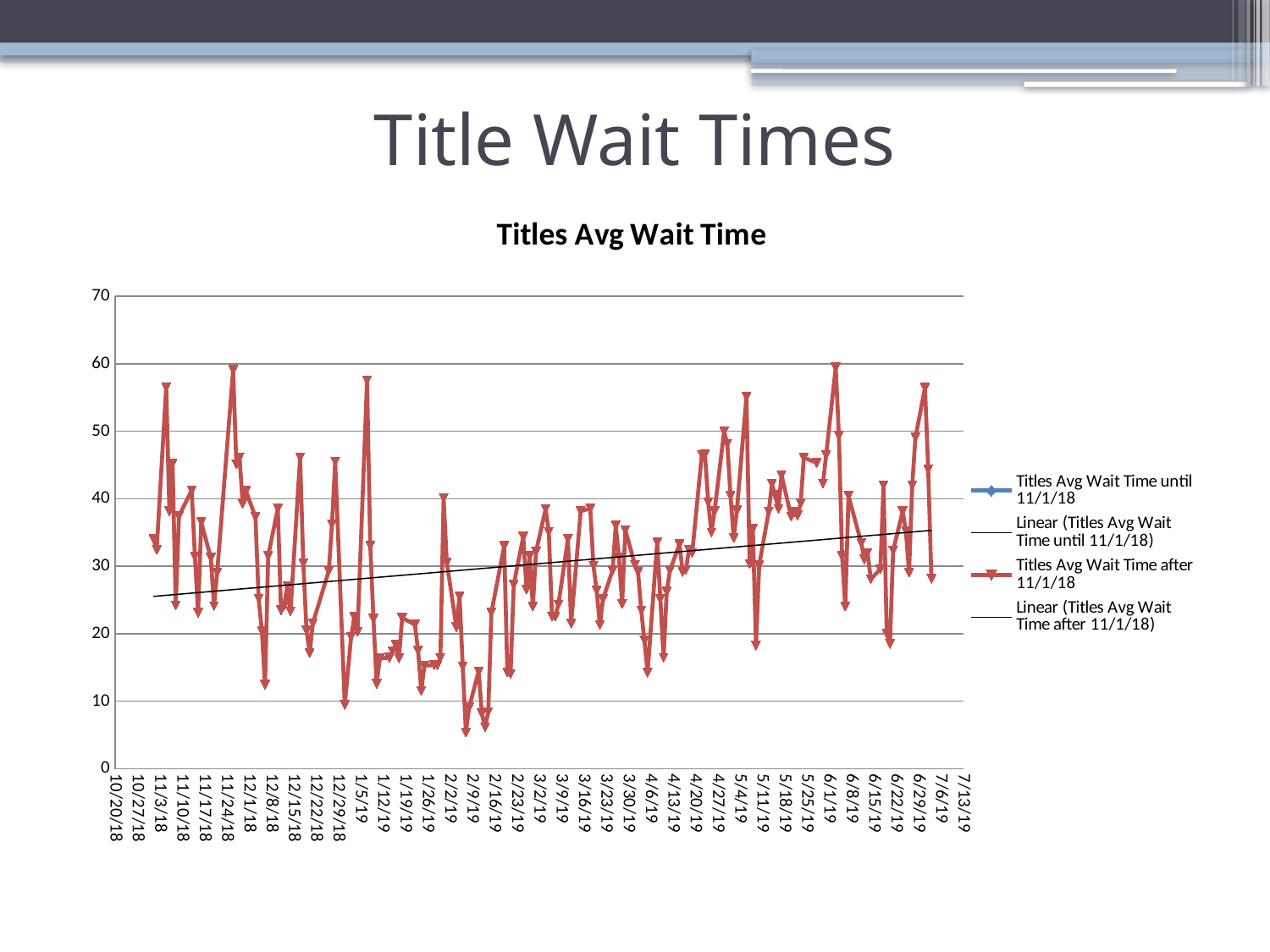
Is the value of the 'Titles Avg Wait Time after 11/1/18' series at its peak near 6/1/19 greater or less than 40? greater Is the value of the 'Titles Avg Wait Time after 11/1/18' series at its dip near 2/9/19 greater or less than 20? less What kind of chart is shown on the slide? Line chart Does the linear trendline for 'Titles Avg Wait Time after 11/1/18' rise or fall from left to right? Rises What is the title of the chart? Titles Avg Wait Time Is the lowest point of the 'Titles Avg Wait Time after 11/1/18' series greater or less than 10? less What is the highest value shown on the vertical axis? 70 What colour is the 'Titles Avg Wait Time after 11/1/18' series plotted in? Red How many entries does the chart legend list? 4